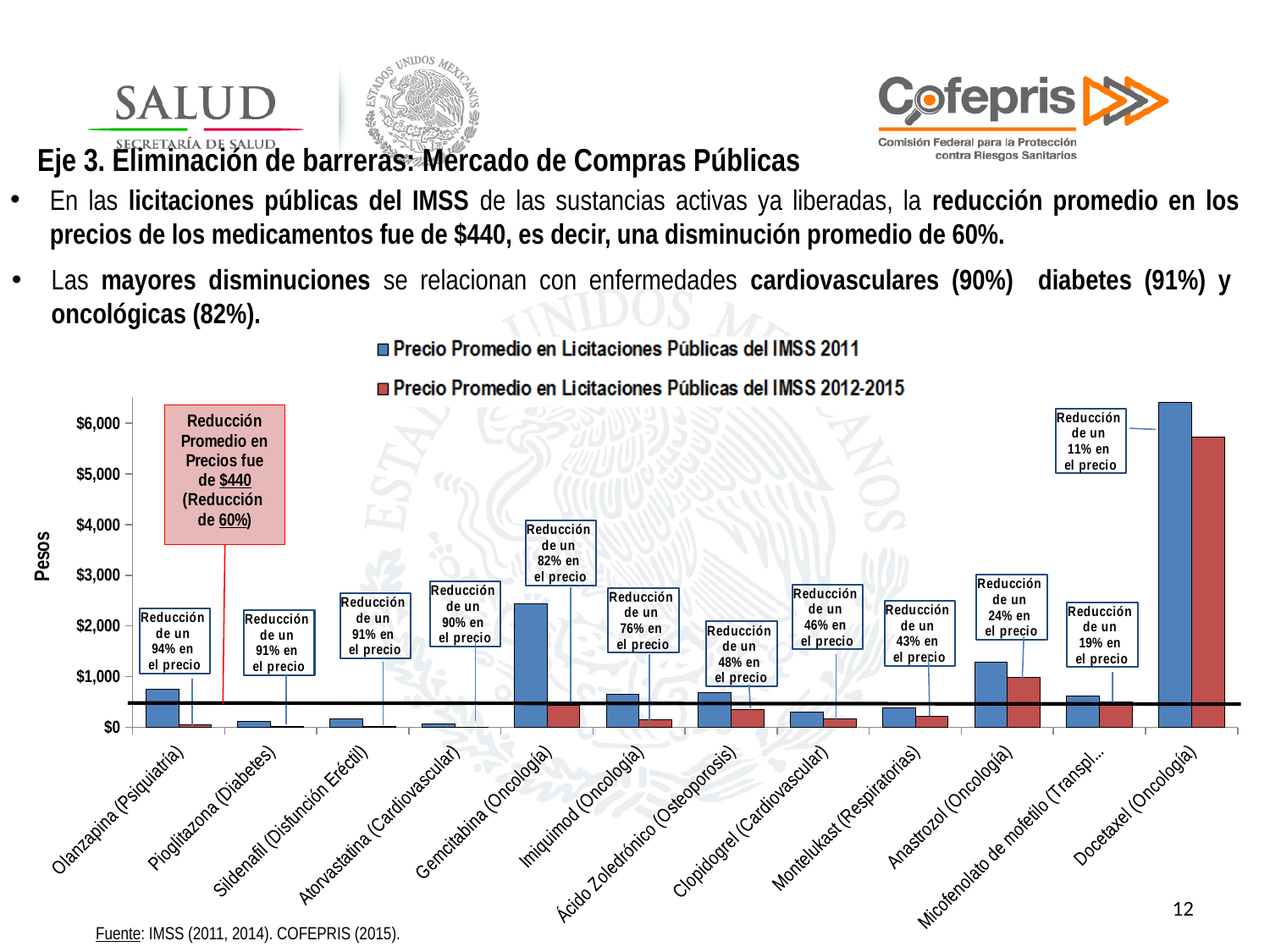
What is the label on the y axis of the chart? Pesos Is the 2012-2015 average price for Docetaxel (Oncología) greater or less than $5,000? greater Is the 2011 average price for Olanzapina (Psiquiatría) greater or less than $1,000? less How many medicines (categories) are shown along the x axis of the chart? 12 Is the 2011 average price for Gemcitabina (Oncología) greater or less than $2,000? greater Which medicine has the highest Precio Promedio en Licitaciones Públicas del IMSS 2011? Docetaxel (Oncología) What kind of chart is shown on the slide? Bar chart According to the annotation on the chart, what was the price reduction for Docetaxel (Oncología)? 11% According to the red box on the chart, what was the average price reduction in pesos? $440 Which is larger: the 2011 average price for Gemcitabina (Oncología) or for Anastrozol (Oncología)? Gemcitabina (Oncología) According to the annotation on the chart, what was the price reduction for Olanzapina (Psiquiatría)? 94% How many series does the chart legend list? 2